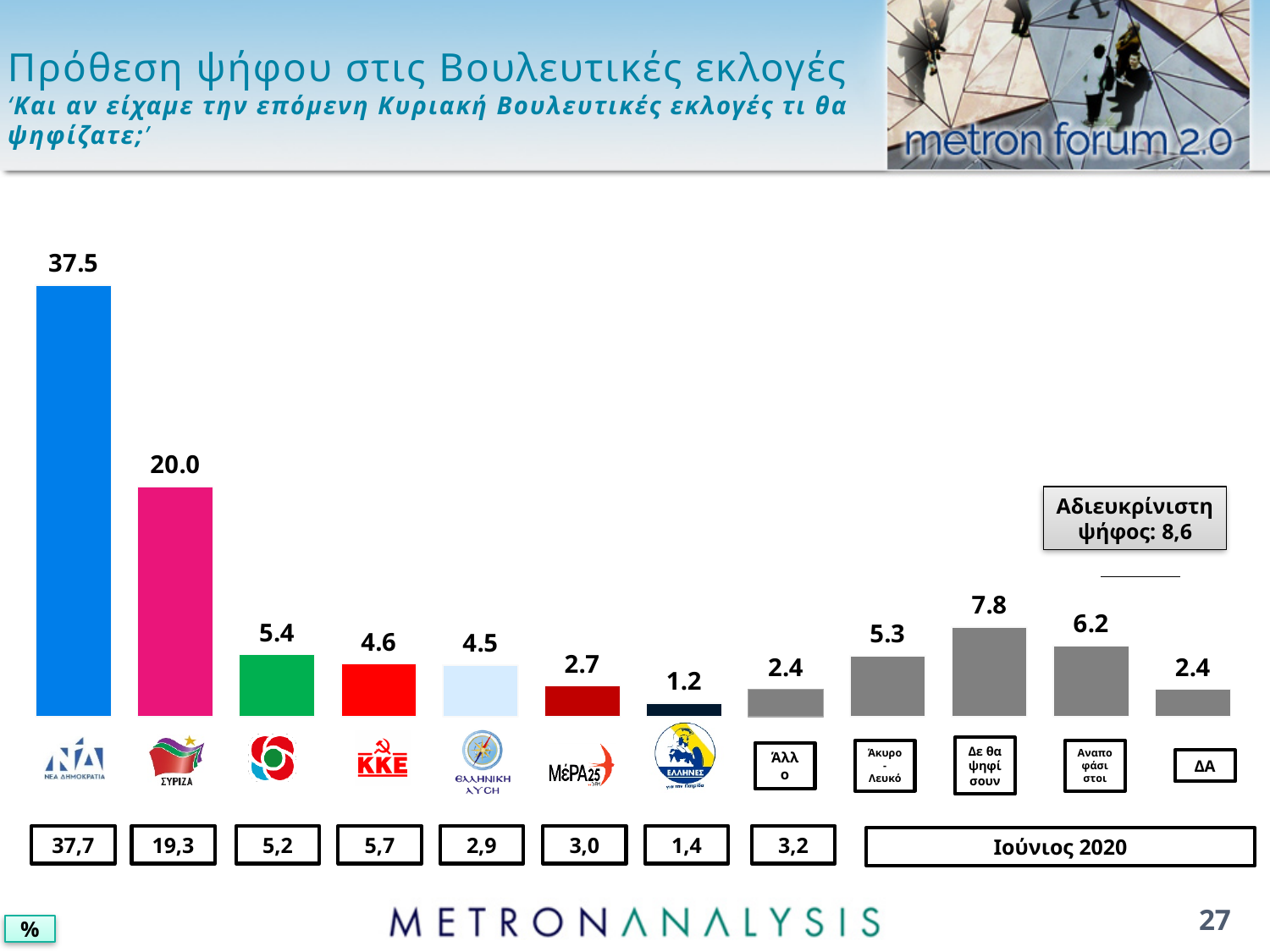
Which category has the highest value? ΝΕΑ ΔΗΜΟΚΡΑΤΙΑ How many bars are plotted in the chart? 12 What type of chart is shown on the slide? bar chart What is the value for ΝΕΑ ΔΗΜΟΚΡΑΤΙΑ? 37.5 What is the value for ΜέΡΑ25? 2.7 What is the difference between the values for ΝΕΑ ΔΗΜΟΚΡΑΤΙΑ and ΣΥΡΙΖΑ? 17.5 Which category has the lowest value? ΕΛΛΗΝΕΣ What is the value for ΚΚΕ? 4.6 What value is given in the box for 'Αδιευκρίνιστη ψήφος'? 8,6 What is the value for 'Δε θα ψηφίσουν'? 7.8 What is the value for ΣΥΡΙΖΑ? 20.0 Which is larger, the value for 'Δε θα ψηφίσουν' or for 'Αναποφάσιστοι'? Δε θα ψηφίσουν